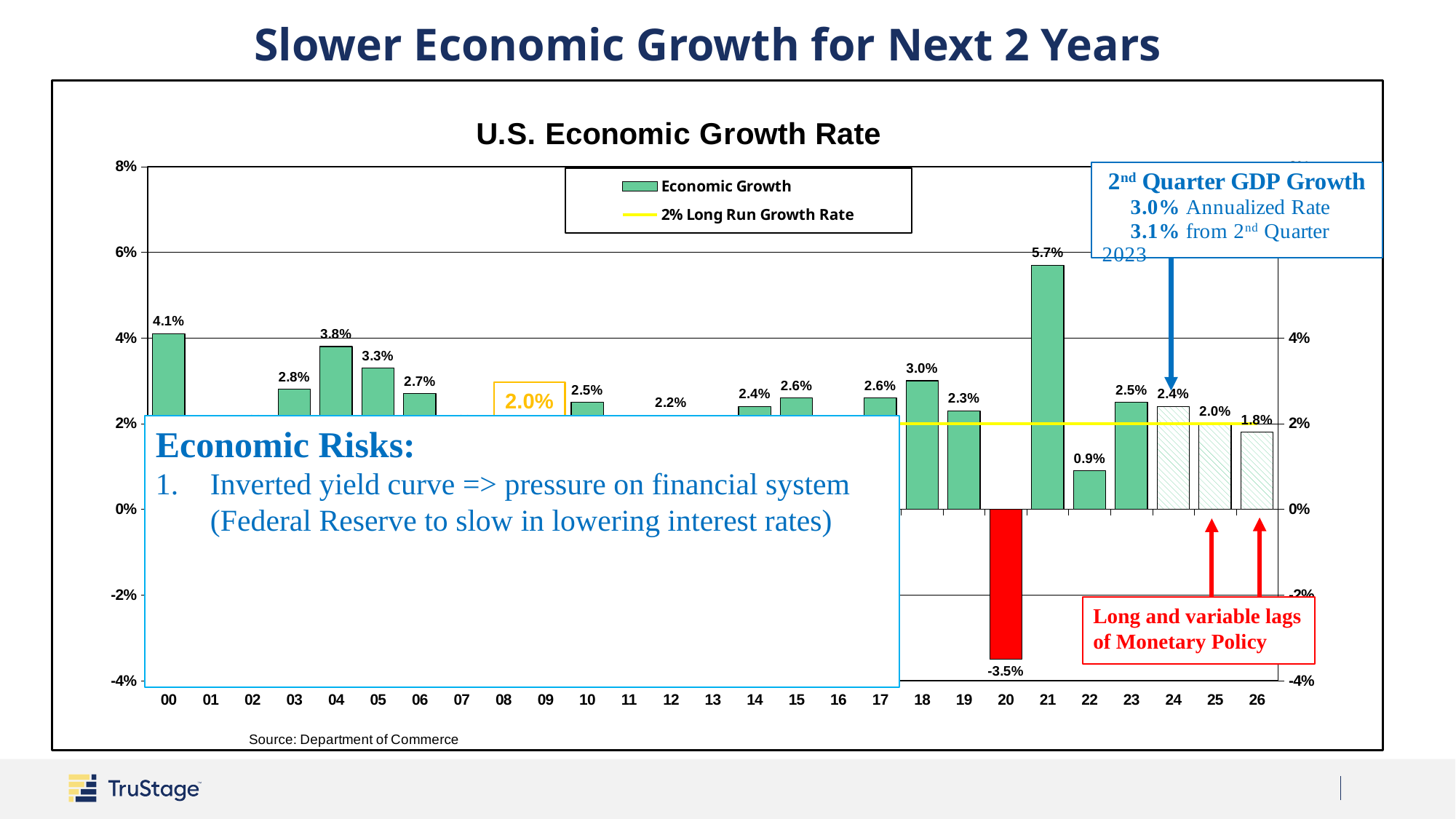
Which year has the larger economic growth rate, 18 or 19? 18 What is the economic growth rate shown for 21 in the U.S. Economic Growth Rate chart? 5.7% What is the economic growth rate shown for 20? -3.5% What kind of chart is used to show the U.S. Economic Growth Rate? bar chart How many series does the chart legend list? 2 What is the economic growth rate shown for 26? 1.8% Is the economic growth rate for 22 greater or less than 2%? less How many years are shown on the x axis of the chart? 27 Do the economic growth rates rise or fall from 24 to 26? fall Which year has the lowest economic growth rate in the chart? 20 Which year has the highest economic growth rate in the chart? 21 What is the difference between the economic growth rates for 04 and 05? 0.5%